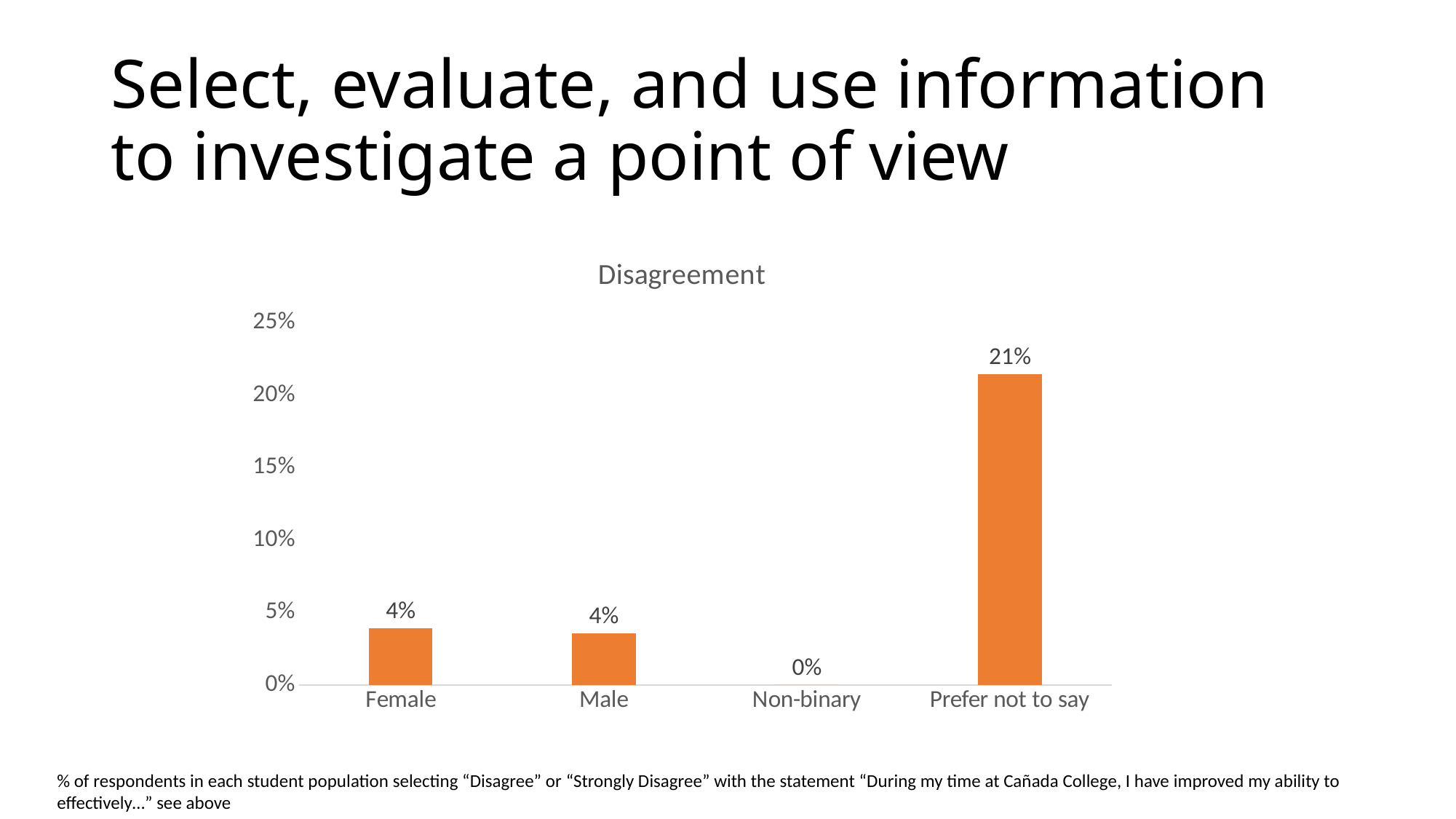
How many categories are shown on the x axis of the Disagreement chart? 4 What is the title of the chart on the slide? Disagreement What is the value for Prefer not to say in the Disagreement chart? 21% Which category has the lowest value in the Disagreement chart? Non-binary Which category has the highest value in the Disagreement chart? Prefer not to say Is the value for Prefer not to say in the Disagreement chart greater or less than 15%? greater What kind of chart is shown on the slide? Bar chart What is the value for Female in the Disagreement chart? 4% What is the value for Non-binary in the Disagreement chart? 0% What is the value for Male in the Disagreement chart? 4% What is the difference between the values for Prefer not to say and Female in the Disagreement chart? 17% Which is larger in the Disagreement chart, the value for Prefer not to say or the value for Male? Prefer not to say